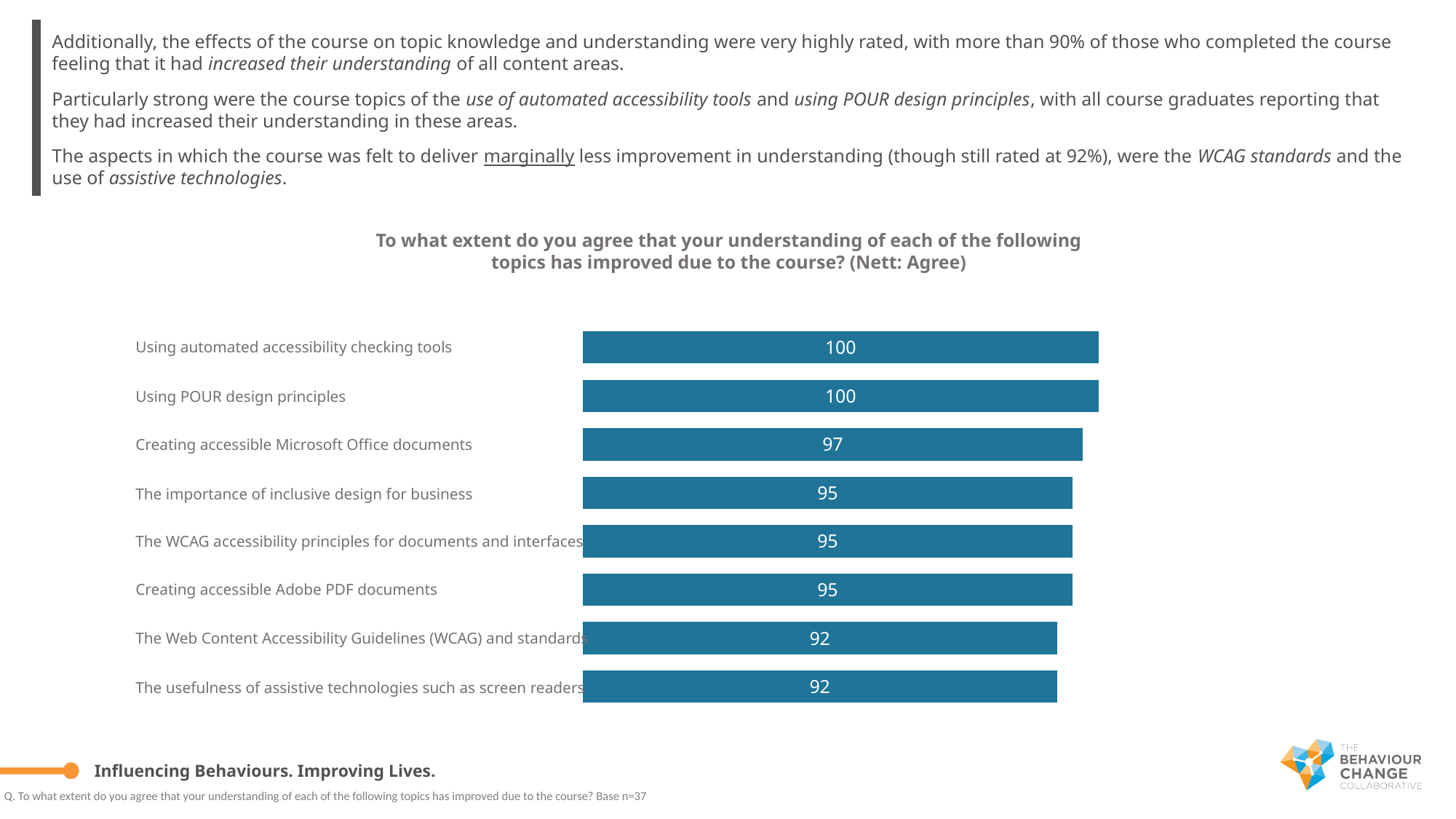
How many categories are shown in the chart? 8 What is the value for 'Creating accessible Microsoft Office documents'? 97 What is the difference between the values for 'Using automated accessibility checking tools' and 'The usefulness of assistive technologies such as screen readers'? 8 Which category has the lowest value, 'Creating accessible Microsoft Office documents' or 'The Web Content Accessibility Guidelines (WCAG) and standards'? The Web Content Accessibility Guidelines (WCAG) and standards What is the difference between the values for 'Creating accessible Microsoft Office documents' and 'The importance of inclusive design for business'? 2 How many categories have a value of 95? 3 What is the value for 'The usefulness of assistive technologies such as screen readers'? 92 What is the value for 'Using POUR design principles'? 100 Which is larger, the value for 'Using POUR design principles' or the value for 'Creating accessible Adobe PDF documents'? Using POUR design principles What is the value for 'Creating accessible Adobe PDF documents'? 95 What is the title of the chart? To what extent do you agree that your understanding of each of the following topics has improved due to the course? (Nett: Agree) What kind of chart is shown on the slide? Bar chart